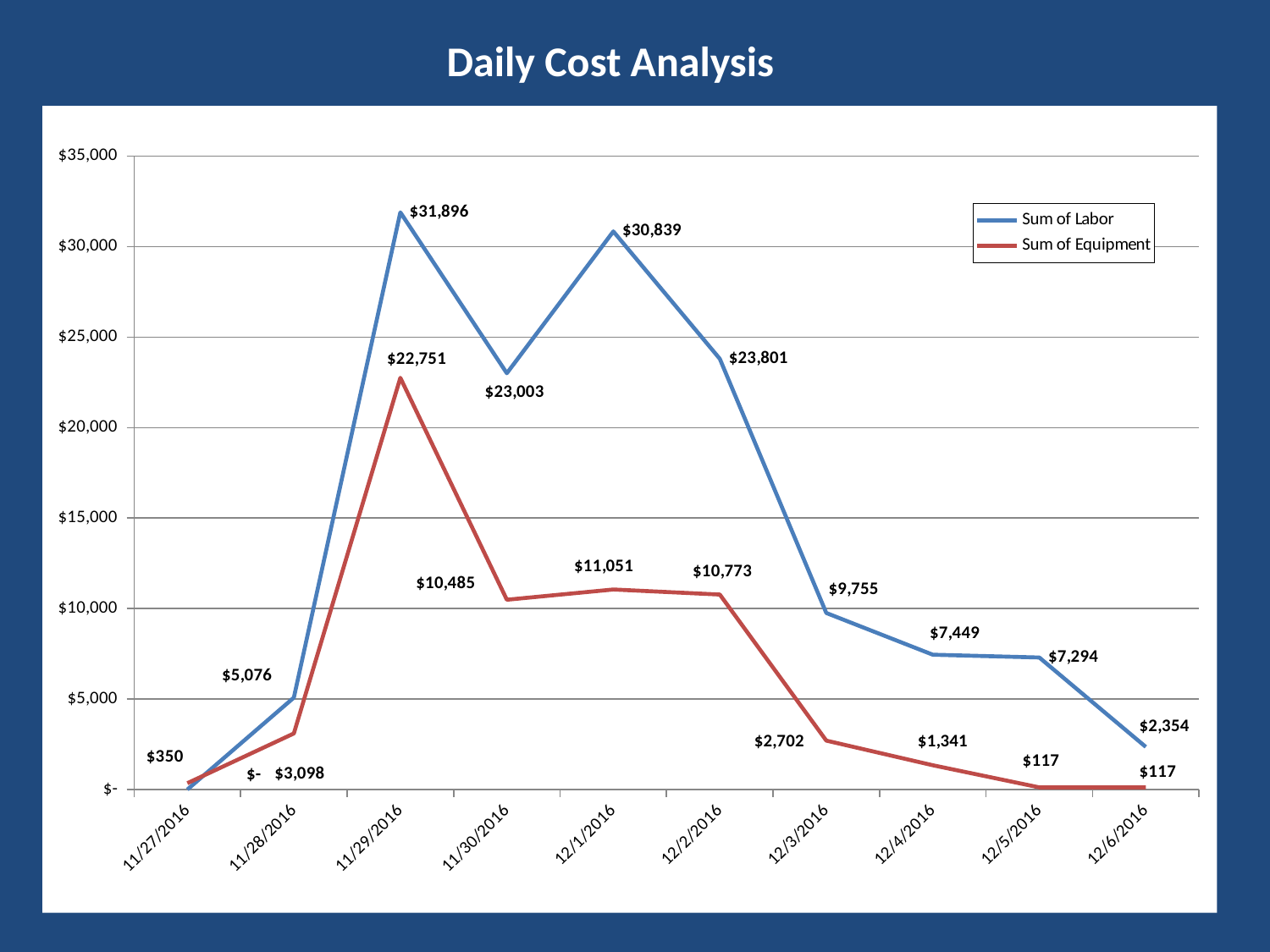
What is the Sum of Labor value on 12/4/2016? $7,449 What is the Sum of Equipment value on 12/1/2016? $11,051 On which date is the Sum of Equipment highest? 11/29/2016 How many series does the legend list? 2 What is the difference between Sum of Labor and Sum of Equipment on 11/29/2016? $9,145 Which is larger on 12/3/2016, Sum of Labor or Sum of Equipment? Sum of Labor Does the Sum of Labor rise or fall from 12/2/2016 to 12/6/2016? Fall How many dates are plotted on the x axis? 10 What is the title of the chart? Daily Cost Analysis What kind of chart is shown on the slide? Line chart On which date is the Sum of Labor highest? 11/29/2016 What is the Sum of Labor value on 11/29/2016? $31,896